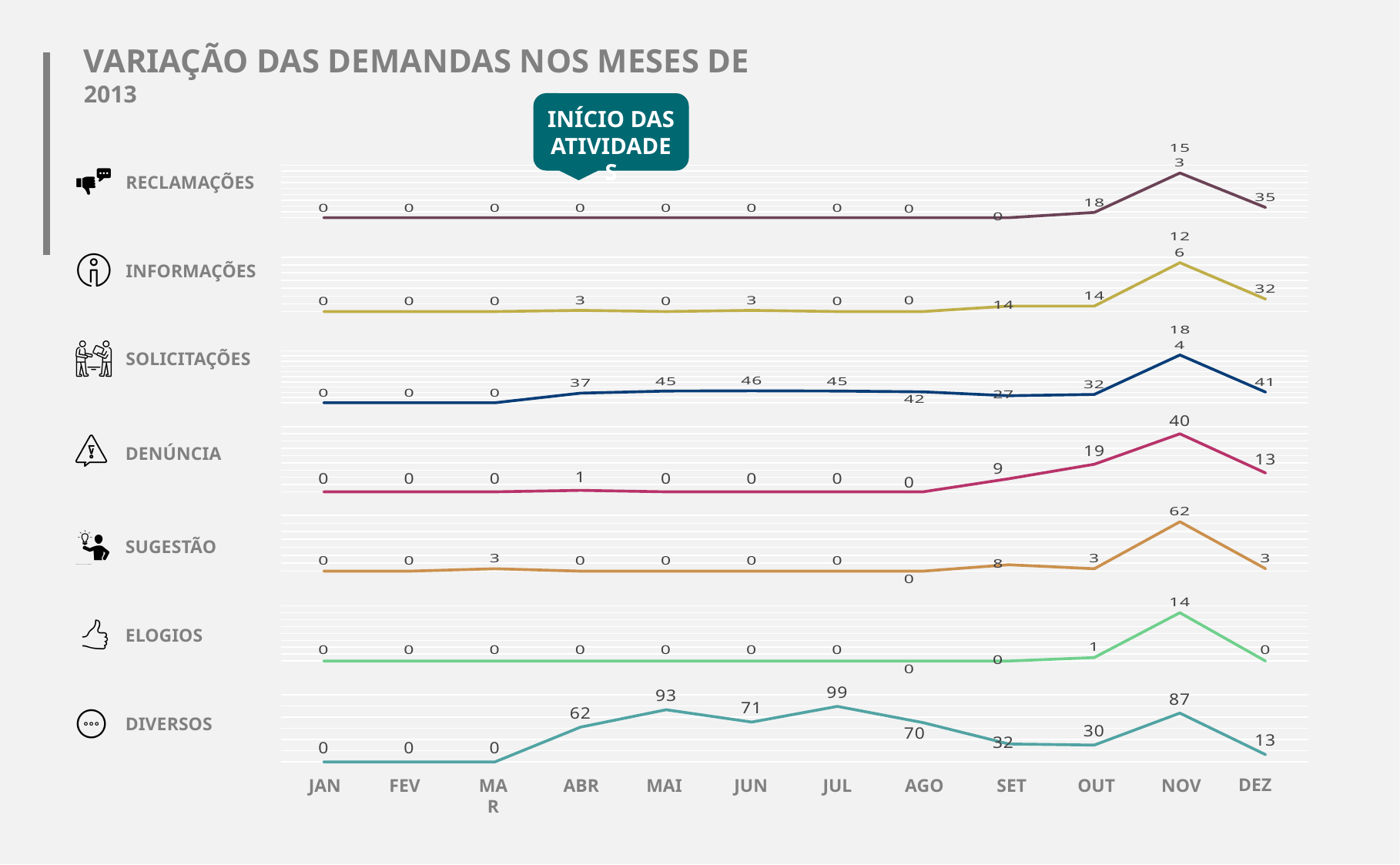
How many months are shown along the x axis of the charts? 12 On the ELOGIOS chart, what is the value for NOV? 14 On the DENÚNCIA chart, what is the value for OUT? 19 On the SOLICITAÇÕES chart, what is the value for JUN? 46 What kind of chart is used for each category on the slide? Line chart On the DIVERSOS chart, what is the value for JUL? 99 On the RECLAMAÇÕES chart, what is the value for DEZ? 35 On the INFORMAÇÕES chart, does the value rise or fall from NOV to DEZ? Fall On the DIVERSOS chart, which month has the highest value? JUL On the DIVERSOS chart, what is the difference between the values for MAI and JUN? 22 On the SUGESTÃO chart, what is the value for NOV? 62 On the DENÚNCIA chart, which is larger, the value for NOV or the value for DEZ? NOV